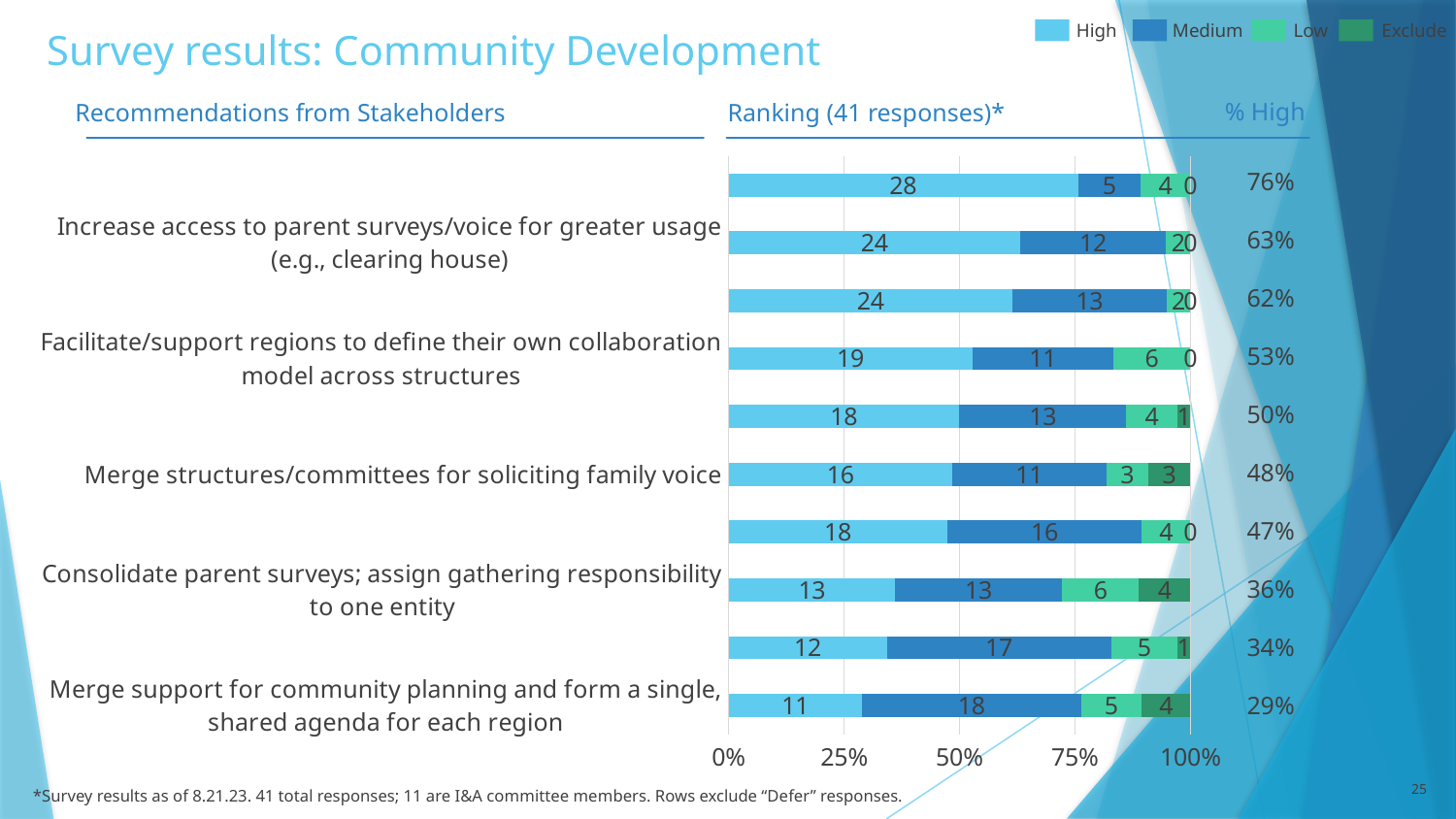
What is the difference between the High value of the topmost bar and the High value of the bottom bar? 17 How many bars are plotted in the chart? 10 How many series does the chart legend list? 4 What is the High value shown on the topmost bar? 28 What is the Medium value shown on the bottom bar? 18 What type of chart is shown on the slide? Stacked bar chart Which bar has the lowest % High value? The bottom bar (29%) What is the total of the segments in the topmost bar (28, 5, 4, 0)? 37 What is the % High value listed for the topmost bar? 76% What are the four legend entries of the chart? High, Medium, Low, Exclude Which bar has the highest High count? The topmost bar (28) Is the High segment of the topmost bar greater or less than 50% of the bar? greater